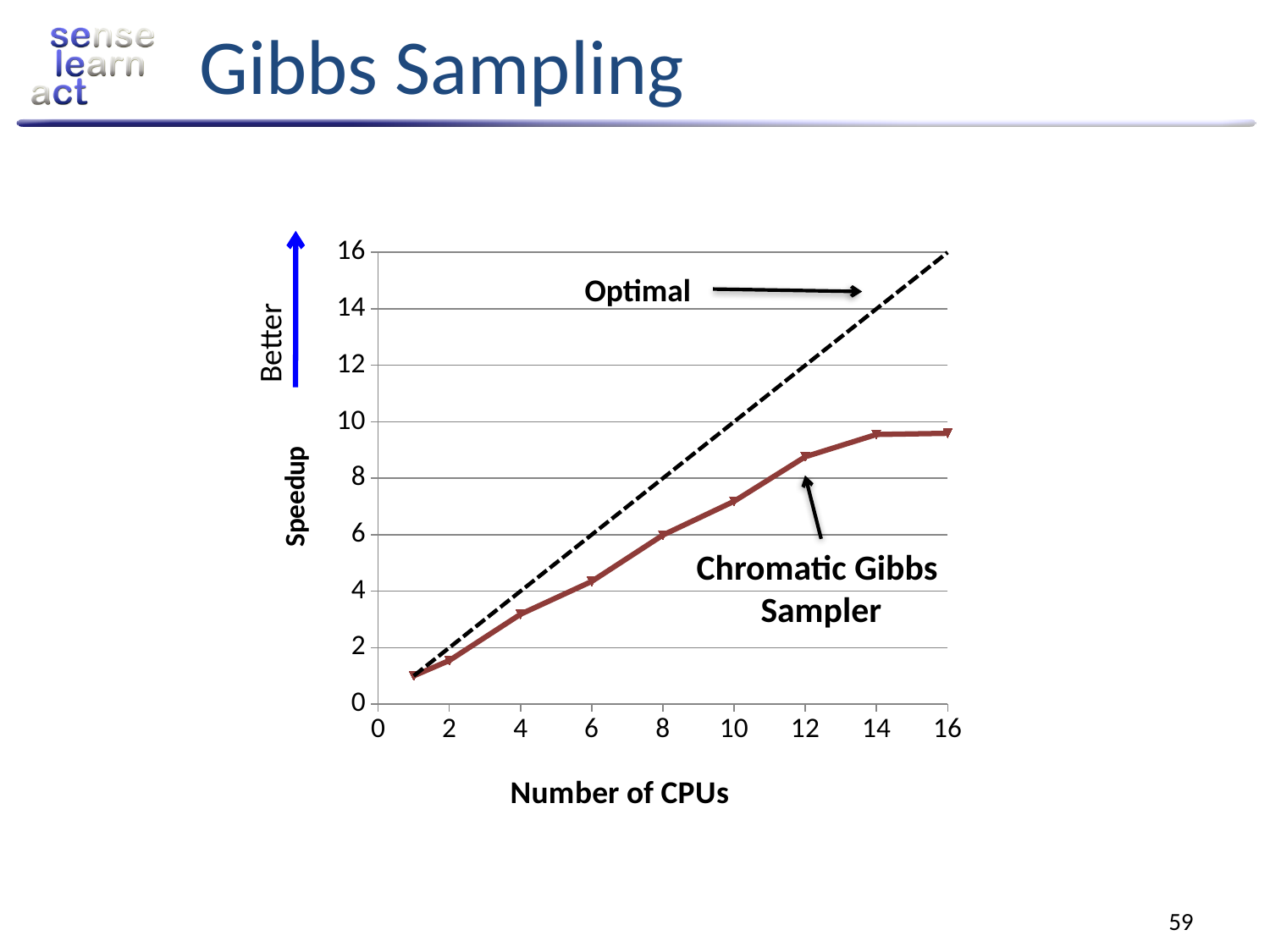
Does the speedup of the Chromatic Gibbs Sampler rise or fall as the number of CPUs increases? rise Is the speedup of the Chromatic Gibbs Sampler at 12 CPUs greater or less than 8? greater At 12 CPUs, which series has the higher speedup, Optimal or Chromatic Gibbs Sampler? Optimal What kind of chart is shown on the slide? line chart What is the title of the y axis? Speedup Is the speedup of the Chromatic Gibbs Sampler at 16 CPUs greater or less than 10? less Is the speedup of the Chromatic Gibbs Sampler at 14 CPUs greater or less than 10? less How many data points are marked on the Chromatic Gibbs Sampler line? 9 What is the title of the x axis? Number of CPUs What is the speedup of the Optimal line at 16 CPUs? 16 How many series are plotted on the chart? 2